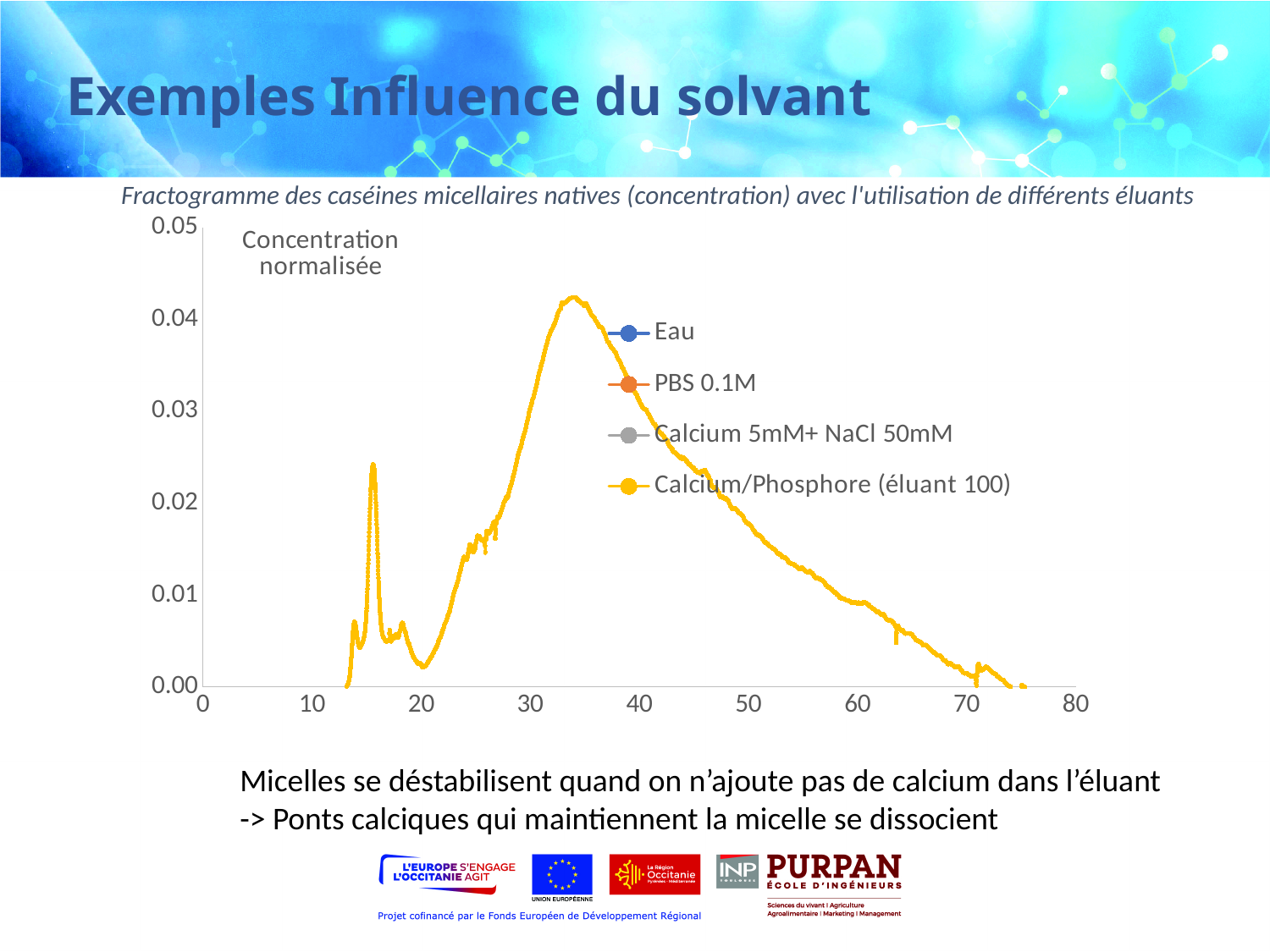
Is the value of the Calcium/Phosphore (éluant 100) curve at x = 50 greater or less than 0.01? greater Is the peak value of the Calcium/Phosphore (éluant 100) curve greater or less than 0.03? greater Is the value of the Calcium/Phosphore (éluant 100) curve at x = 50 greater or less than 0.02? less Between x = 40 and x = 70, does the Calcium/Phosphore (éluant 100) curve rise or fall? fall How many series does the chart legend list? 4 What is the title of the chart? Fractogramme des caséines micellaires natives (concentration) avec l'utilisation de différents éluants Which legend entry is drawn in yellow? Calcium/Phosphore (éluant 100) Between x = 25 and x = 33, does the Calcium/Phosphore (éluant 100) curve rise or fall? rise What is the highest tick value shown on the x axis? 80 What kind of chart is shown on the slide? line chart